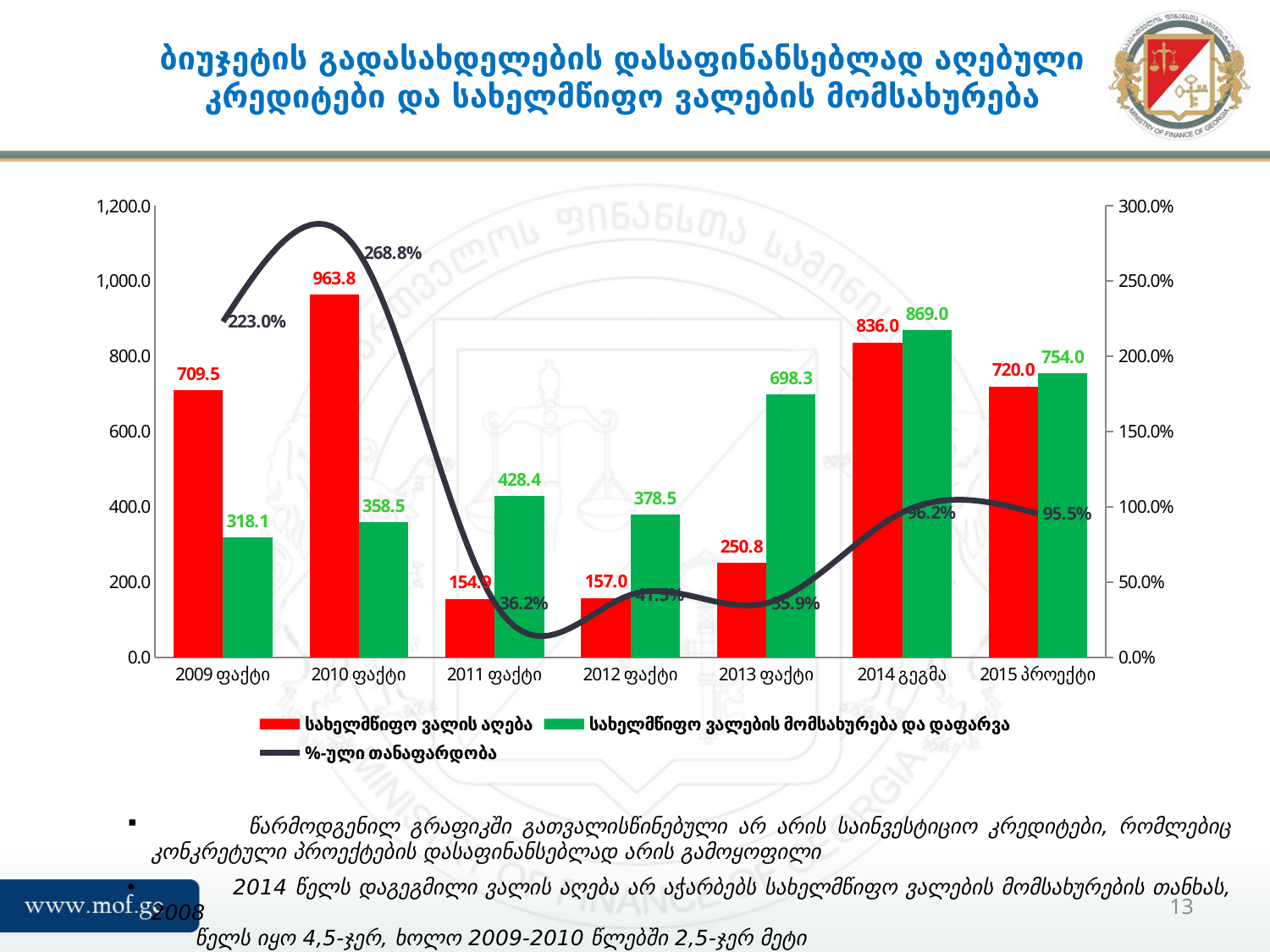
For 2011 ფაქტი, which is larger: the red bar or the green bar? the green bar Is the red bar value for 2015 პროექტი greater or less than 600.0? greater Which category has the highest red bar (სახელმწიფო ვალის აღება)? 2010 ფაქტი Which colour represents სახელმწიფო ვალის აღება in the legend? red What is the difference between the green bar and the red bar for 2014 გეგმა? 33.0 What is the value of the red bar (სახელმწიფო ვალის აღება) for 2010 ფაქტი? 963.8 How many series does the legend list? 3 What percentage does the line (%-ული თანაფარდობა) show for 2010 ფაქტი? 268.8% How many categories are shown on the x axis? 7 What kind of chart is shown on the slide? a combined bar and line chart Which category has the lowest green bar (სახელმწიფო ვალების მომსახურება და დაფარვა)? 2009 ფაქტი What is the value of the green bar (სახელმწიფო ვალების მომსახურება და დაფარვა) for 2013 ფაქტი? 698.3